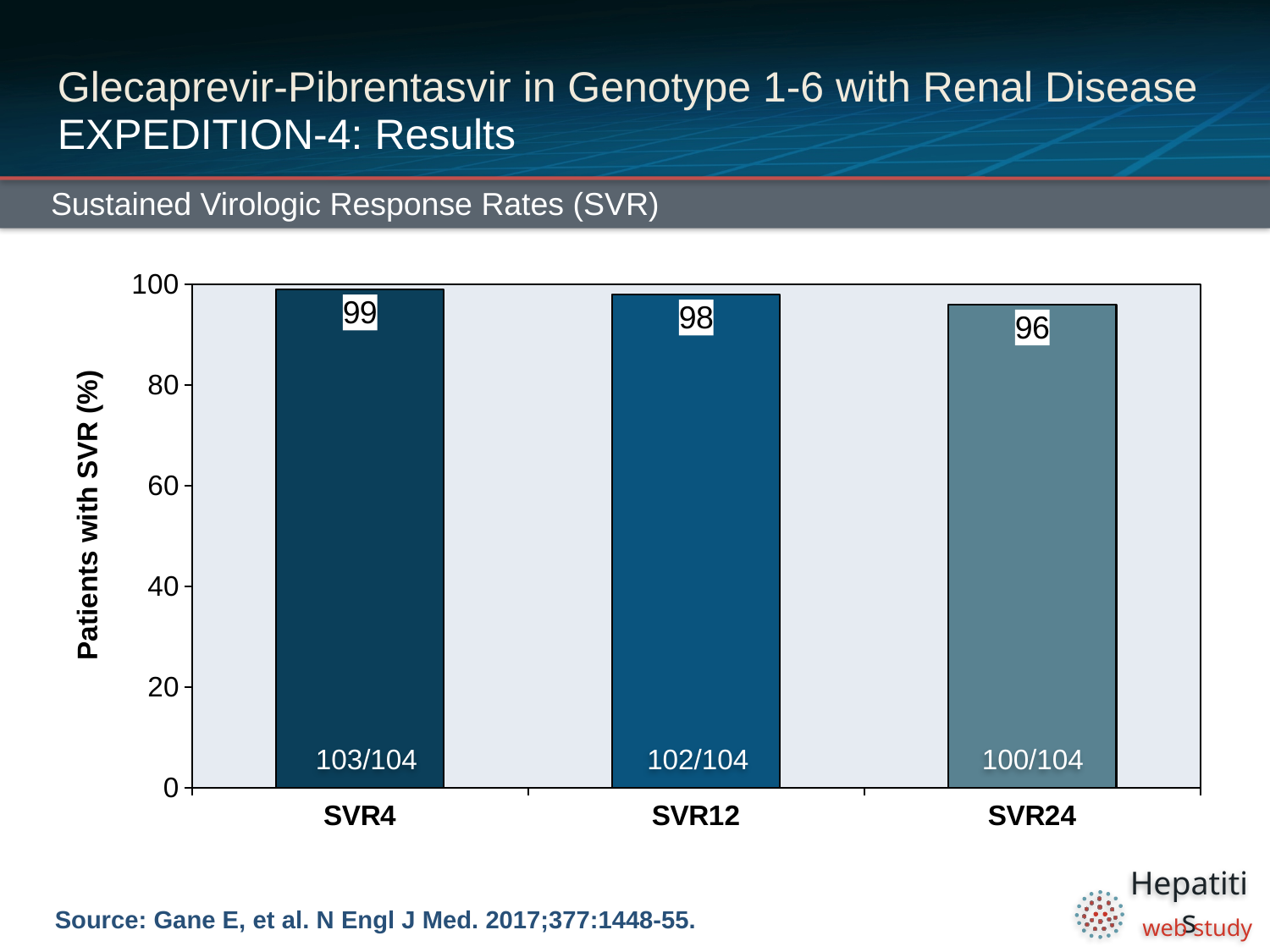
What fraction of patients is shown inside the SVR24 bar? 100/104 Which category has the highest SVR rate? SVR4 Which is larger, the SVR rate for SVR12 or for SVR24? SVR12 What kind of chart is shown on the slide? Bar chart What fraction of patients is shown inside the SVR4 bar? 103/104 What is the SVR rate (%) for SVR24? 96 How many categories are shown on the x axis? 3 What is the difference in SVR rate between SVR4 and SVR24? 3 What is the SVR rate (%) for SVR4? 99 Which category has the lowest SVR rate? SVR24 What is the label of the y axis? Patients with SVR (%) What is the SVR rate (%) for SVR12? 98